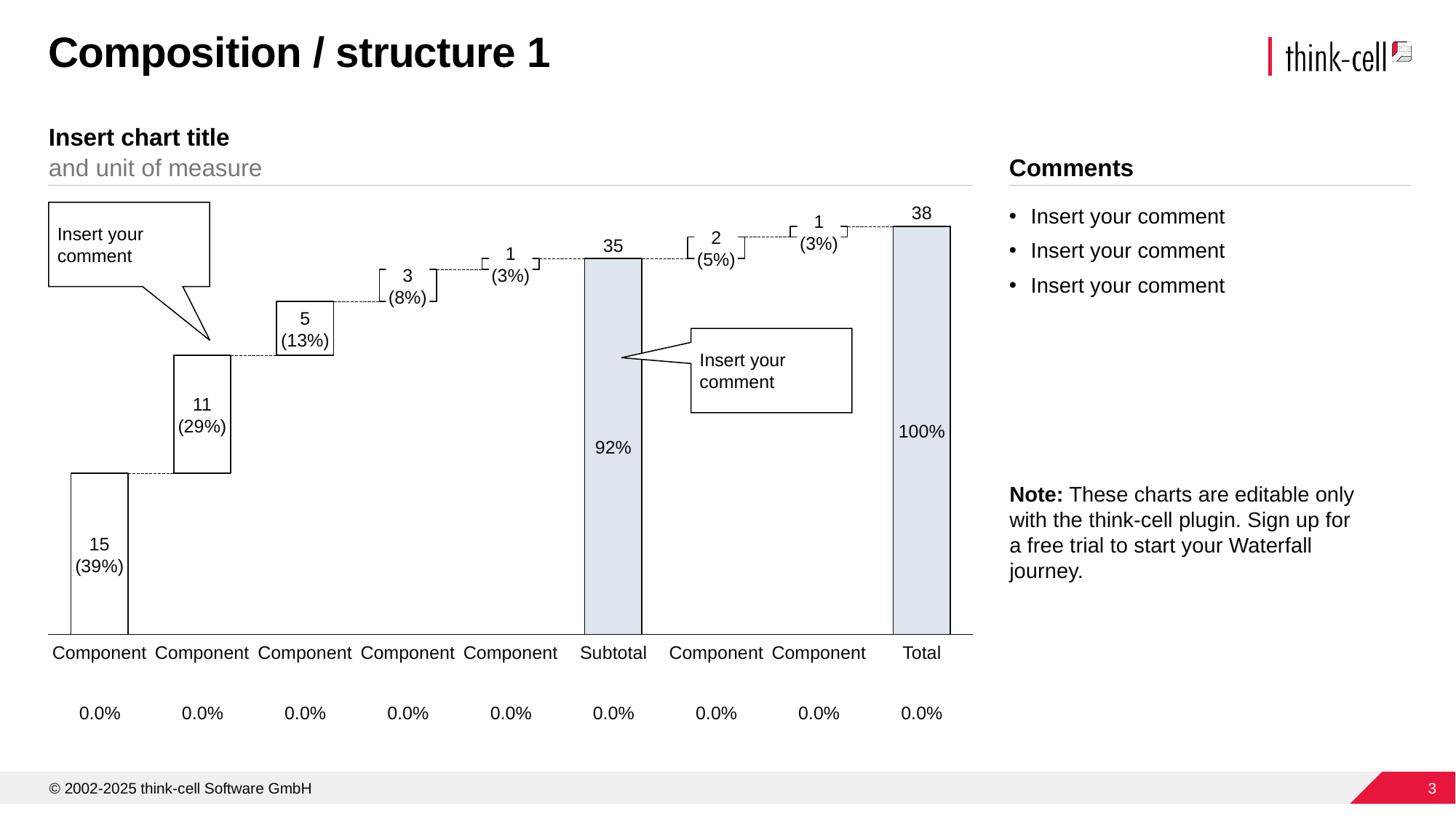
What percentage share is shown for the first Component bar on the left? 39% What is the value of the first Component bar on the left? 15 What kind of chart is shown? Waterfall chart What is the difference between the Total and the Subtotal values? 3 Which is larger, the first Component bar or the second Component bar? The first Component bar What is the chart's title placeholder text? Insert chart title What is the difference between the first Component bar (15) and the second Component bar (11)? 4 How many bars are plotted along the x axis? 9 What is the value of the Subtotal bar? 35 What is the value of the Total bar? 38 What percentage is shown inside the Subtotal bar? 92% Which bar has the highest value? Total